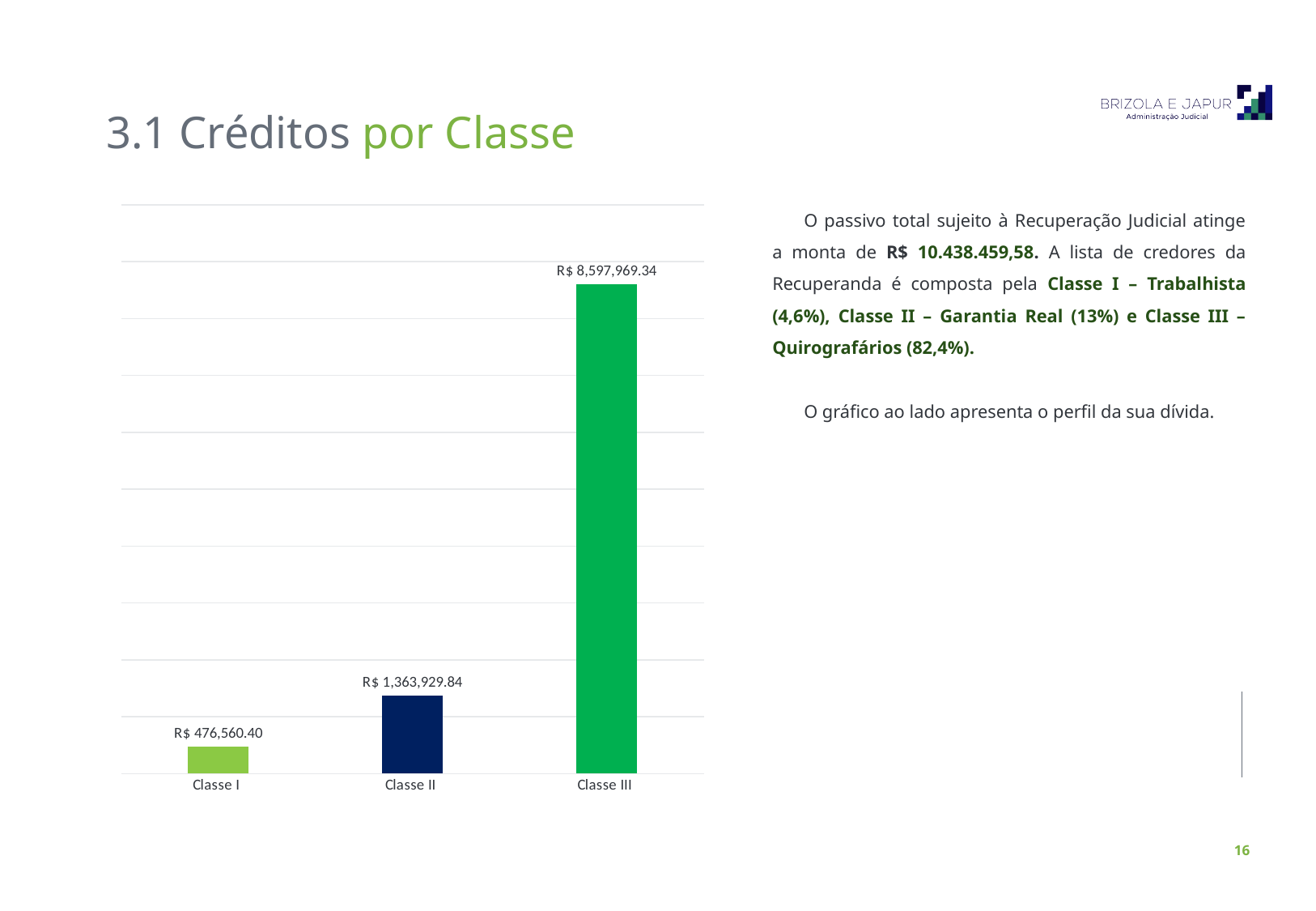
Which is larger, the value for Classe II or the value for Classe I? Classe II What kind of chart is shown on the slide? Bar chart How many classes are shown in the chart? 3 What is the difference between the values for Classe II and Classe I? R$ 887,369.44 What is the value for Classe I? R$ 476,560.40 Which class has the highest value? Classe III Do the values rise or fall from Classe I to Classe III? Rise What is the difference between the values for Classe III and Classe II? R$ 7,234,039.50 What is the value for Classe III? R$ 8,597,969.34 Which class has the lowest value? Classe I What is the value for Classe II? R$ 1,363,929.84 What colour is the bar for Classe II? Dark navy blue